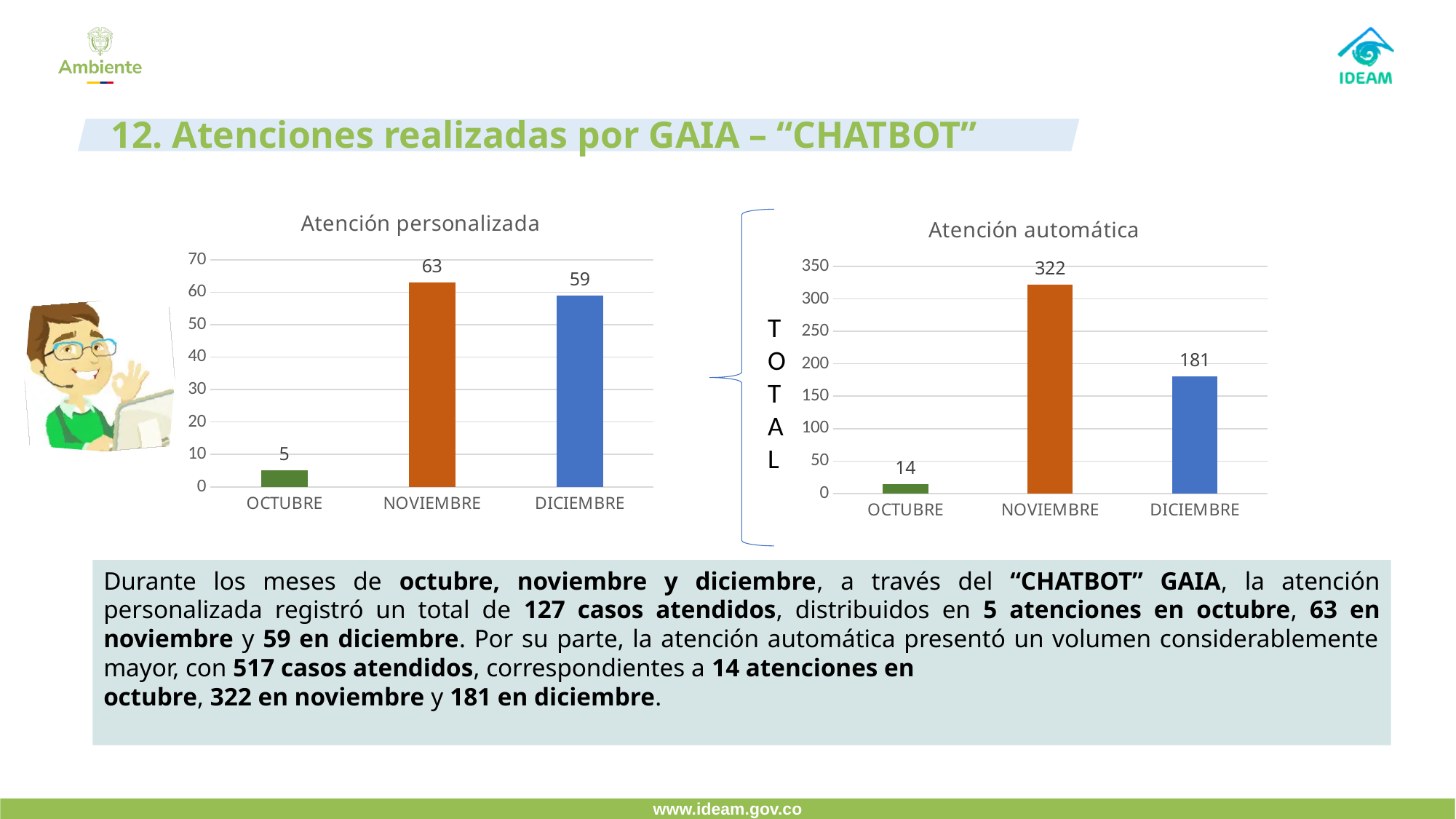
In the 'Atención automática' chart, what is the difference between the NOVIEMBRE and DICIEMBRE values? 141 What is the title of the chart on the right side of the slide? Atención automática How many months are shown in the 'Atención automática' chart? 3 In the 'Atención automática' chart, what is the value for DICIEMBRE? 181 What kind of chart is the 'Atención personalizada' chart? bar chart In the 'Atención automática' chart, is the value for OCTUBRE greater or less than 50? less In the 'Atención personalizada' chart, which is larger, the value for NOVIEMBRE or DICIEMBRE? NOVIEMBRE In the 'Atención personalizada' chart, which month has the lowest value? OCTUBRE In the 'Atención personalizada' chart, what is the value for NOVIEMBRE? 63 In the 'Atención personalizada' chart, what is the total of the three monthly values? 127 In the 'Atención personalizada' chart, what is the difference between the NOVIEMBRE and OCTUBRE values? 58 In the 'Atención automática' chart, which month has the highest value? NOVIEMBRE